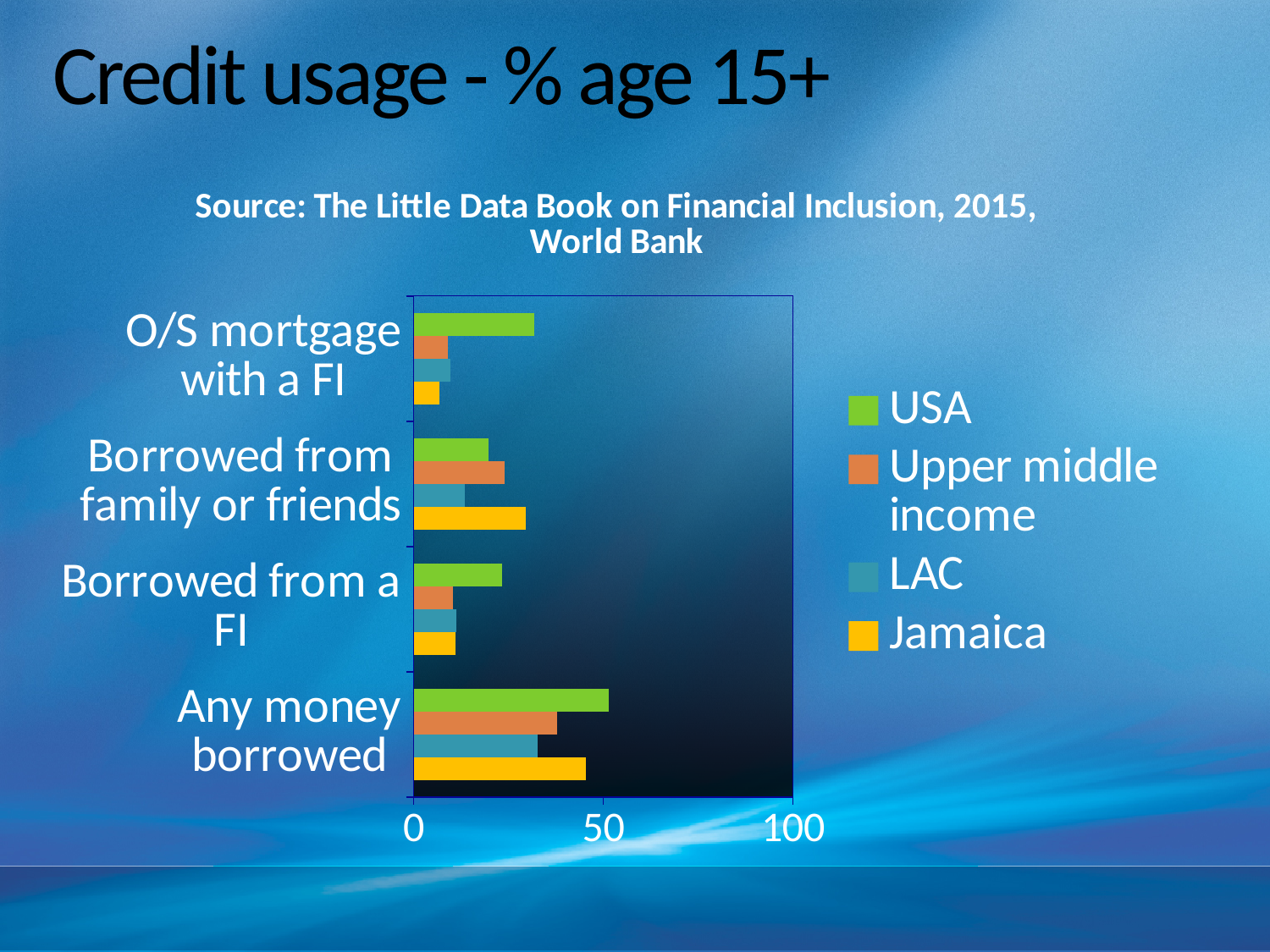
For Borrowed from family or friends, which is larger: USA or Jamaica? Jamaica What colour represents Jamaica in the chart? yellow Which series has the highest value for Borrowed from family or friends? Jamaica Is the value for Jamaica in Any money borrowed greater or less than 50? less Is the value for Upper middle income in Any money borrowed greater or less than 50? less Which category has the highest value for USA? Any money borrowed How many series does the legend list? 4 What kind of chart is shown on the slide? bar chart How many categories are shown on the chart? 4 For O/S mortgage with a FI, which is larger: USA or Jamaica? USA Which series has the highest value for Any money borrowed? USA What are the entries listed in the legend? USA, Upper middle income, LAC, Jamaica